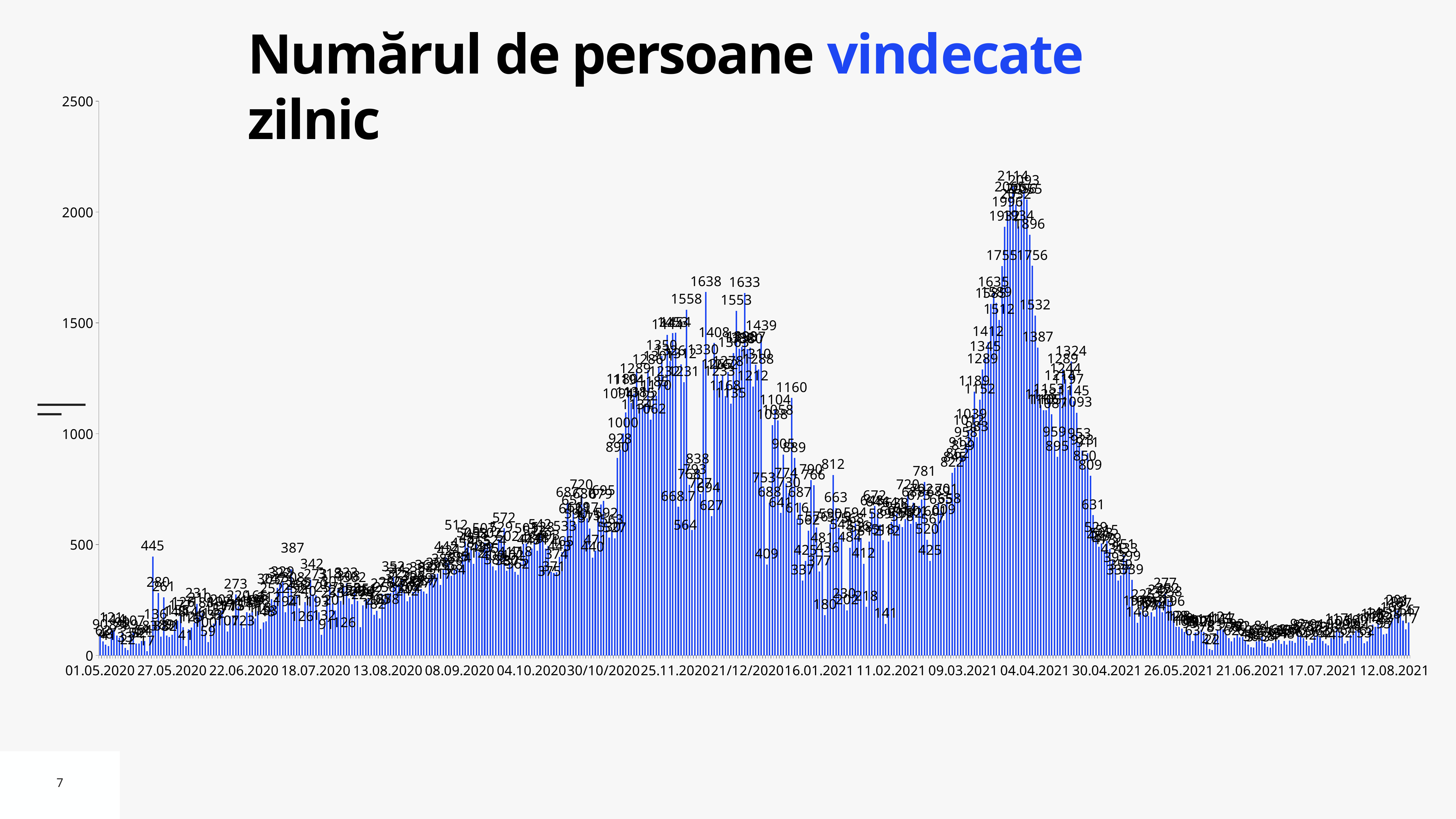
Is the value at 04.04.2021 greater or less than 1500? greater What kind of chart is shown on the slide? bar chart Which is larger: the peak around 04.04.2021 or the peak around 25.11.2020? the peak around 04.04.2021 What is the maximum value shown on the y axis? 2500 Around which x-axis date does the chart reach its highest peak? 04.04.2021 Do the values rise or fall between 09.03.2021 and 04.04.2021? rise Is the value at 12.08.2021 greater or less than 500? less What is the value of the tallest bar in May 2020? 445 Do the values rise or fall between 04.04.2021 and 26.05.2021? fall What is the highest value labeled on the chart? 2114 What is the title of the chart? Numărul de persoane vindecate zilnic Is the value at 21.06.2021 greater or less than 500? less